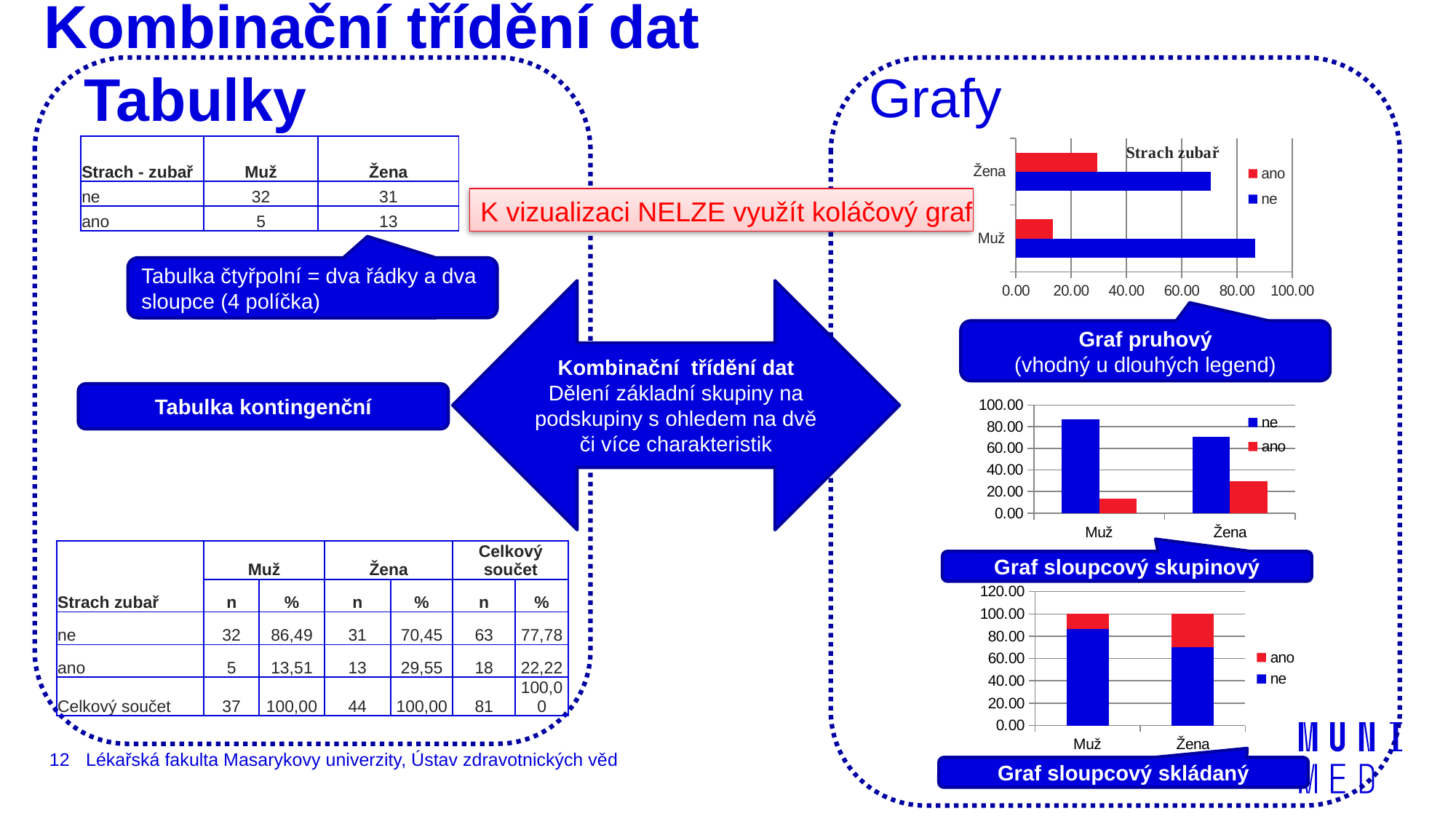
In the middle grouped bar chart (Graf sloupcový skupinový), which category has the larger "ne" bar, Muž or Žena? Muž In the top chart titled "Strach zubař", how many series does the legend list? 2 In the top chart titled "Strach zubař", which series is shown in red? ano In the top chart titled "Strach zubař", is the value of "ano" for Žena greater or less than 40.00? less In the bottom stacked bar chart (Graf sloupcový skládaný), how many series does the legend list? 2 In the middle grouped bar chart (Graf sloupcový skupinový), is the "ne" bar for Žena greater or less than 60.00? greater In the middle grouped bar chart (Graf sloupcový skupinový), how many categories are shown on the x axis? 2 In the bottom stacked bar chart (Graf sloupcový skládaný), is the "ne" portion for Žena greater or less than 60.00? greater What kind of chart is the top chart titled "Strach zubař"? bar chart In the top chart titled "Strach zubař", which category has the larger "ano" bar, Muž or Žena? Žena